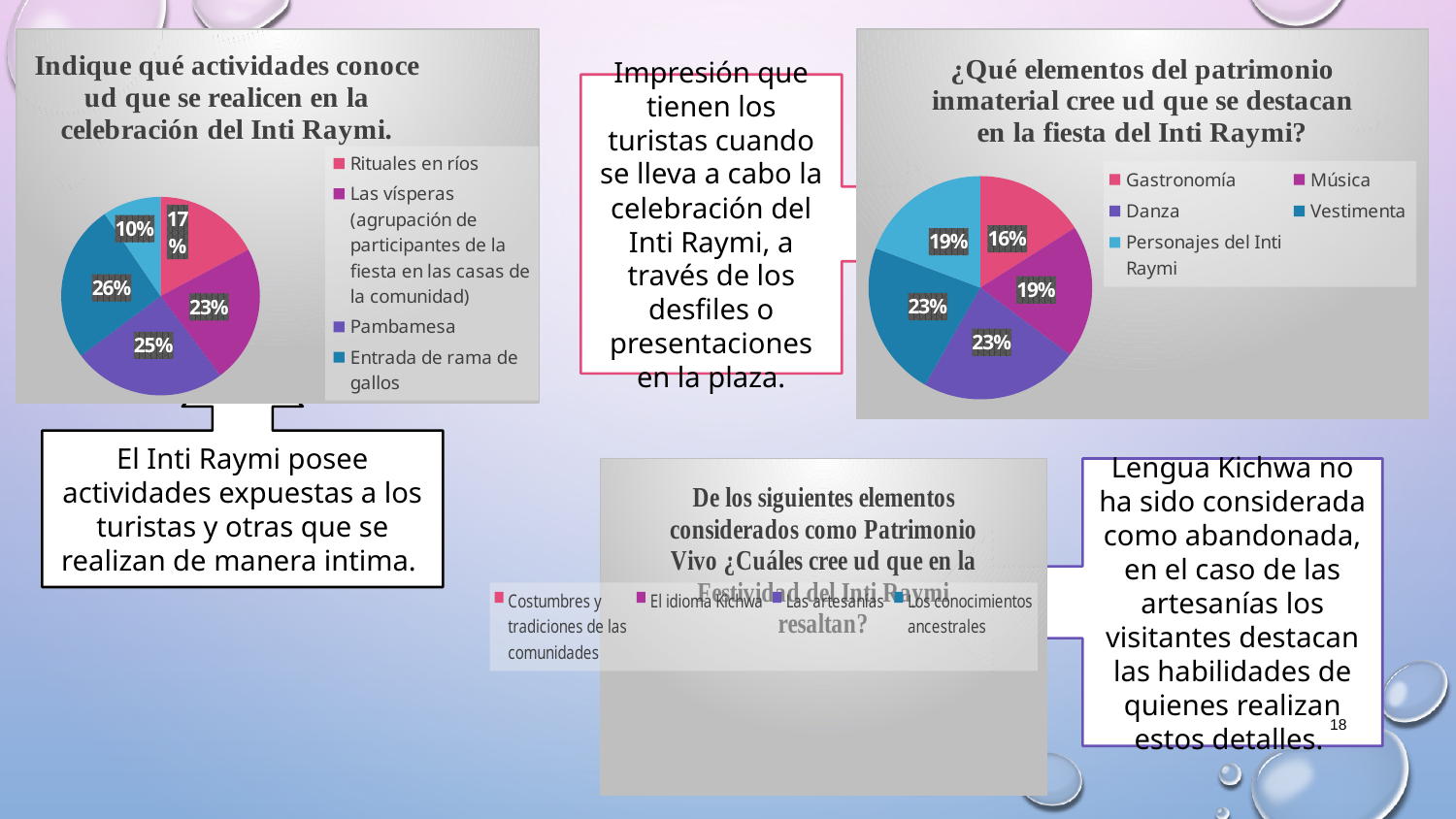
In the pie chart titled 'Indique qué actividades conoce ud que se realicen en la celebración del Inti Raymi', what percentage is shown for Pambamesa? 25% In the pie chart titled '¿Qué elementos del patrimonio inmaterial cree ud que se destacan en la fiesta del Inti Raymi?', what percentage is shown for Danza? 23% In the chart at the bottom of the slide titled 'De los siguientes elementos considerados como Patrimonio Vivo ¿Cuáles cree ud que en la Festividad del Inti Raymi resaltan?', how many entries does the legend list? 4 In the pie chart titled '¿Qué elementos del patrimonio inmaterial cree ud que se destacan en la fiesta del Inti Raymi?', what percentage is shown for Gastronomía? 16% In the pie chart titled 'Indique qué actividades conoce ud que se realicen en la celebración del Inti Raymi', what is the largest percentage shown on any slice? 26% In the pie chart titled 'Indique qué actividades conoce ud que se realicen en la celebración del Inti Raymi', what is the smallest percentage shown on any slice? 10% In the pie chart titled 'Indique qué actividades conoce ud que se realicen en la celebración del Inti Raymi', what percentage is shown for Rituales en ríos? 17% In the pie chart titled 'Indique qué actividades conoce ud que se realicen en la celebración del Inti Raymi', how many slices does the pie have? 5 What type of chart is used for the question '¿Qué elementos del patrimonio inmaterial cree ud que se destacan en la fiesta del Inti Raymi?'? Pie chart In the pie chart titled '¿Qué elementos del patrimonio inmaterial cree ud que se destacan en la fiesta del Inti Raymi?', which element has the smallest share? Gastronomía In the pie chart titled '¿Qué elementos del patrimonio inmaterial cree ud que se destacan en la fiesta del Inti Raymi?', what is the difference in percentage points between Danza and Gastronomía? 7 In the pie chart titled '¿Qué elementos del patrimonio inmaterial cree ud que se destacan en la fiesta del Inti Raymi?', how many categories does the legend list? 5